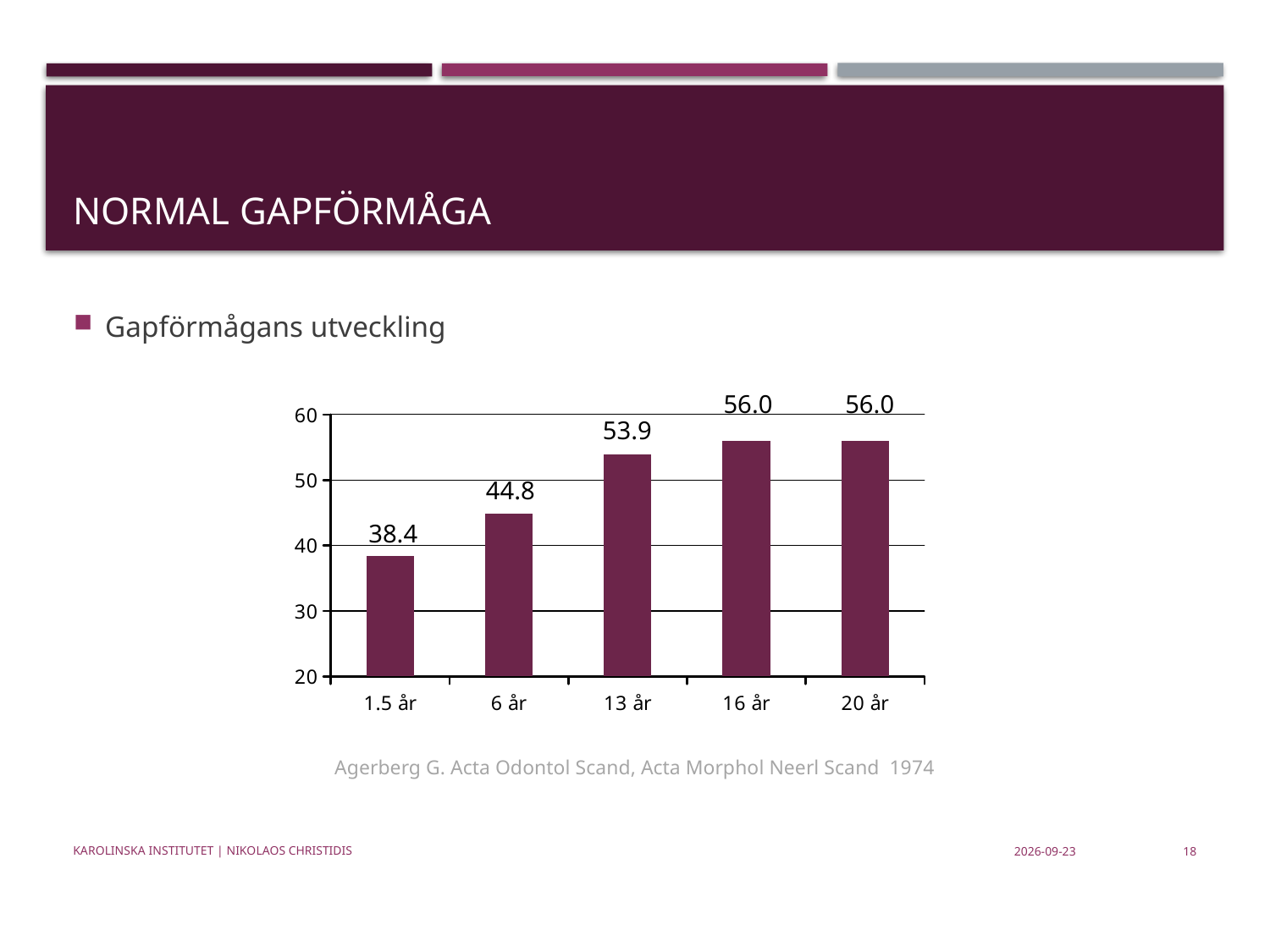
What kind of chart is shown on the slide? bar chart Which category has the lowest value? 1.5 år Which is larger, the value for 6 år or the value for 13 år? 13 år What is the value for 1.5 år? 38.4 What is the value for 16 år? 56.0 What is the difference between the values for 13 år and 6 år? 9.1 What is the difference between the values for 20 år and 1.5 år? 17.6 What is the value for 6 år? 44.8 How many categories are shown on the x axis? 5 Is the value for 1.5 år greater or less than 40? less Do the values rise or fall from 1.5 år to 16 år? rise What is the value for 13 år? 53.9